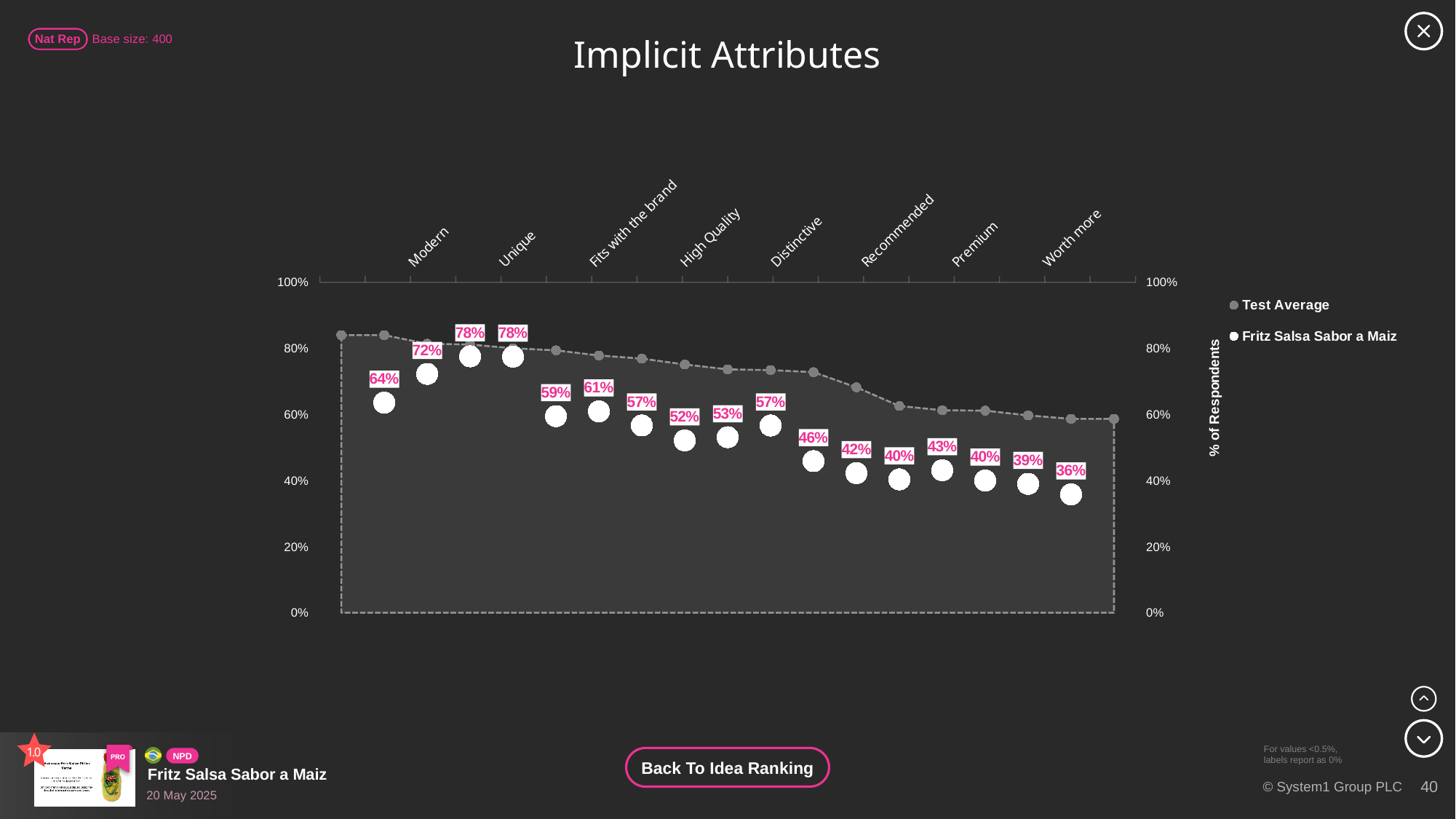
What is the label on the vertical axis of the chart? % of Respondents What are the two series named in the legend? Test Average and Fritz Salsa Sabor a Maiz What is the highest labelled value for Fritz Salsa Sabor a Maiz? 78% What is the difference between the highest (78%) and lowest (36%) labelled values for Fritz Salsa Sabor a Maiz? 42 percentage points What is the title of the chart? Implicit Attributes Do the Fritz Salsa Sabor a Maiz values generally rise or fall from left to right across the chart? Fall What is the value of the leftmost labelled Fritz Salsa Sabor a Maiz point? 64% How many labelled data points are plotted for Fritz Salsa Sabor a Maiz? 17 How many series does the chart legend list? 2 What is the lowest labelled value for Fritz Salsa Sabor a Maiz? 36% Which is larger, the leftmost labelled Fritz Salsa Sabor a Maiz value or the rightmost one? The leftmost (64%) What is the value of the rightmost labelled Fritz Salsa Sabor a Maiz point? 36%